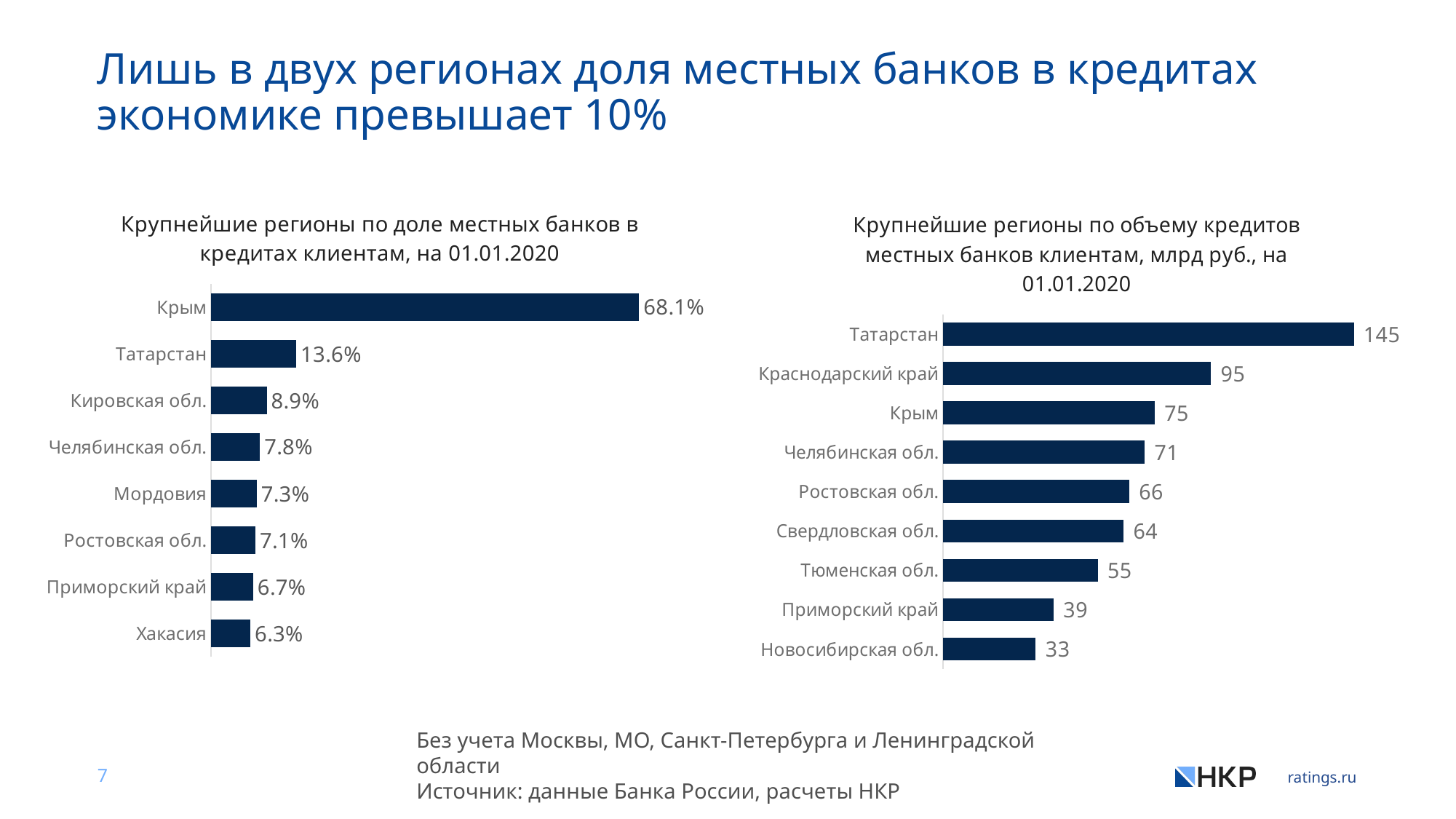
In the left chart (share of local banks in loans to clients), what is the value for Татарстан? 13.6% In the right chart (volume of loans of local banks, bn rub.), what is the value for Краснодарский край? 95 In the right chart (volume of loans of local banks, bn rub.), which region has the largest volume? Татарстан In the left chart (share of local banks in loans to clients), which region has the highest share? Крым In the right chart (volume of loans of local banks, bn rub.), which region has the smallest volume? Новосибирская обл. What type of chart is used on the left side of the slide? Bar chart In the left chart (share of local banks in loans to clients), what is the difference between Крым and Татарстан? 54.5 percentage points In the right chart (volume of loans of local banks, bn rub.), which is larger: Ростовская обл. or Тюменская обл.? Ростовская обл. In the right chart (volume of loans of local banks, bn rub.), what is the difference between Татарстан and Крым? 70 In the right chart (volume of loans of local banks, bn rub.), how many regions are shown? 9 In the left chart (share of local banks in loans to clients), how many regions are shown? 8 In the left chart (share of local banks in loans to clients), which region has the lowest share? Хакасия